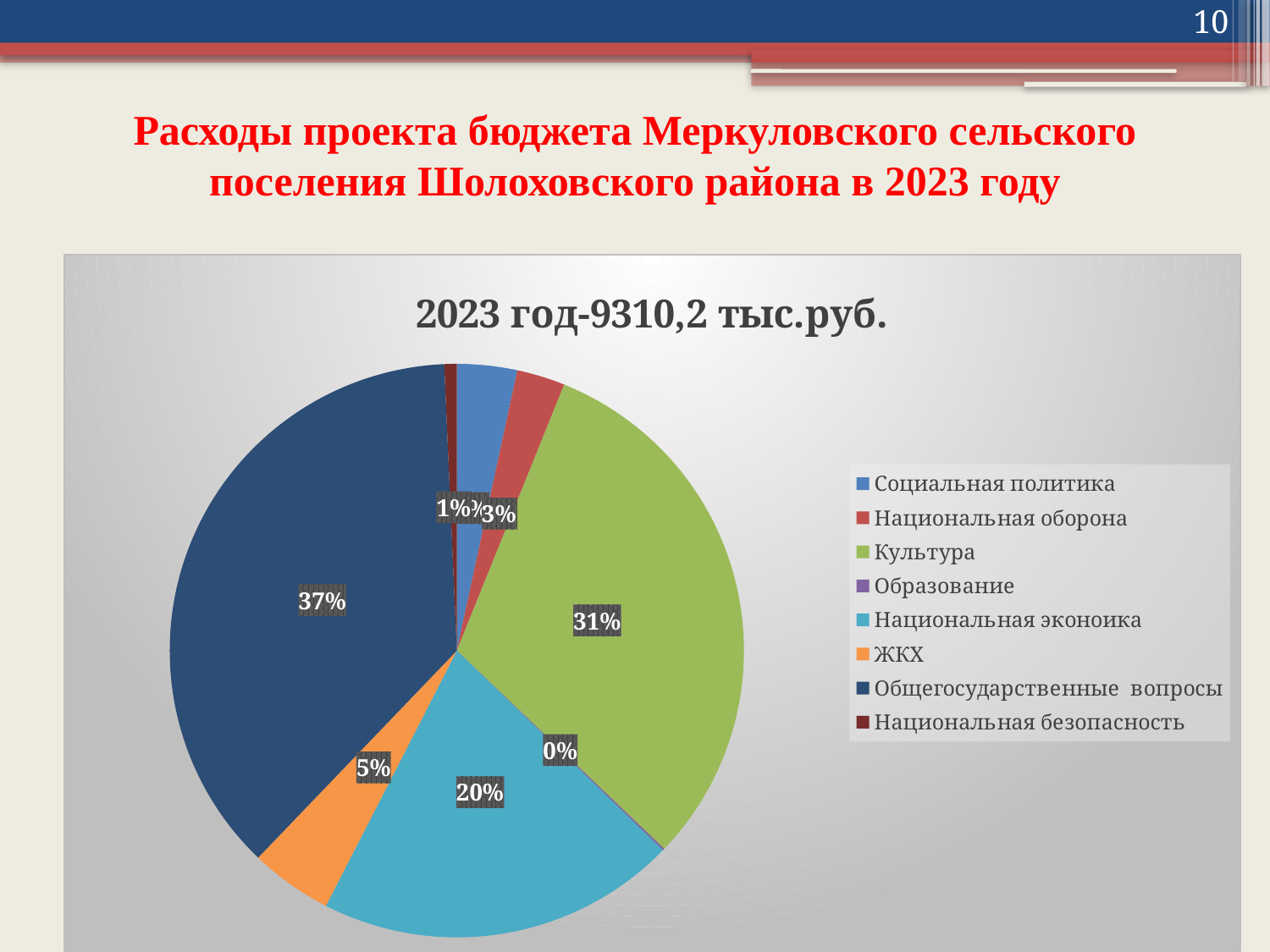
What share of the pie does Общегосударственные вопросы have? 37% What share of the pie does Национальная эконоика have? 20% What share of the pie does Культура have? 31% What is the title of the pie chart? 2023 год-9310,2 тыс.руб. What share of the pie does ЖКХ have? 5% What is the difference in percentage points between the shares of Общегосударственные вопросы and Культура? 6 How many categories does the legend of the pie chart list? 8 Which is larger in the pie chart: Культура or Национальная эконоика? Культура What colour is the Культура slice in the pie chart? green What kind of chart is shown on the slide? pie chart Which category has the largest share of the pie chart? Общегосударственные вопросы What share of the pie does Образование have? 0%